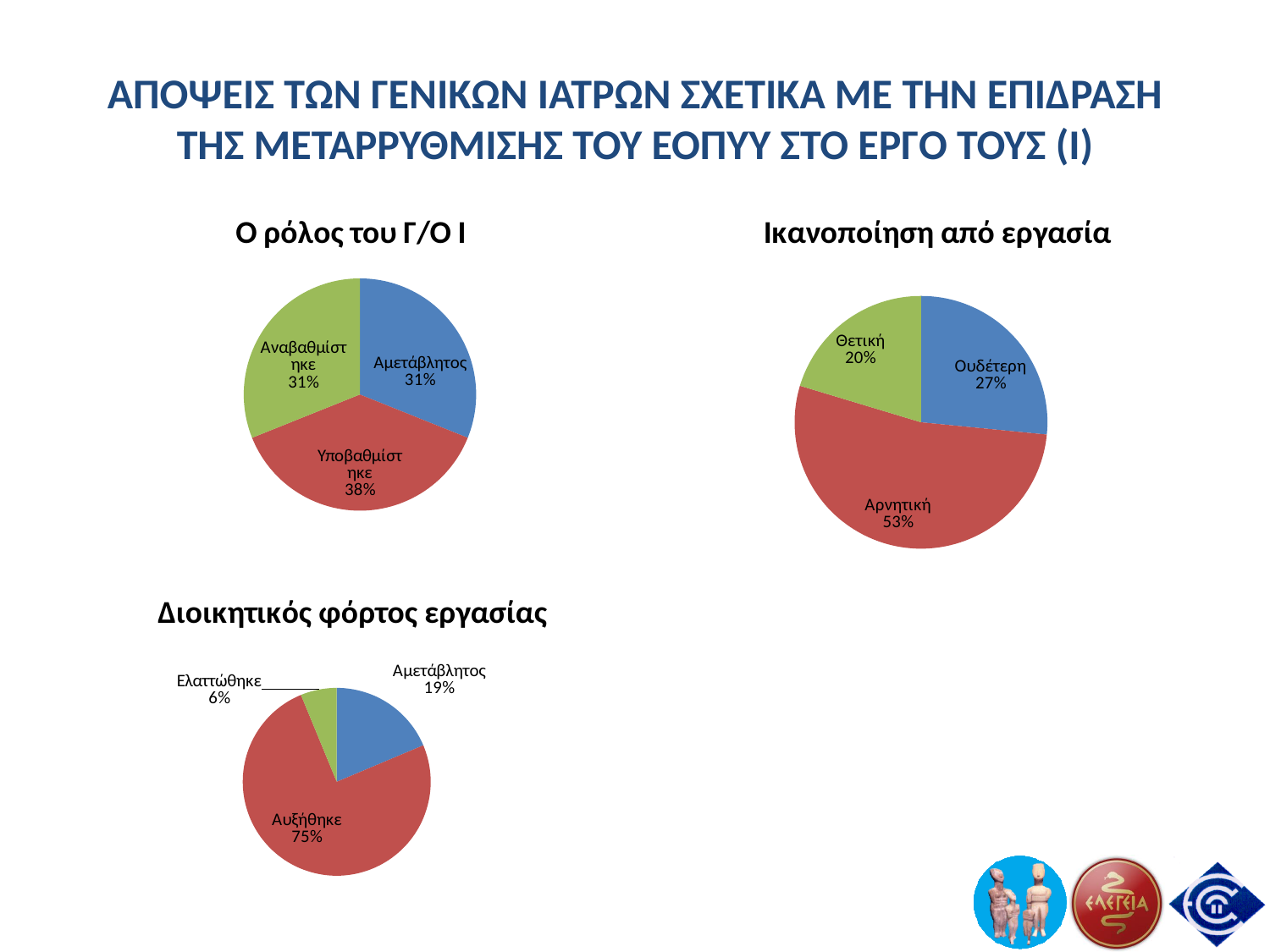
In the chart titled "Ο ρόλος του Γ/Ο Ι", how many slices does the pie have? 3 In the chart titled "Ο ρόλος του Γ/Ο Ι", what share does "Υποβαθμίστηκε" have? 38% In the chart titled "Ο ρόλος του Γ/Ο Ι", which category has the largest slice? Υποβαθμίστηκε In the chart titled "Ικανοποίηση από εργασία", what share does "Αρνητική" have? 53% In the chart titled "Διοικητικός φόρτος εργασίας", what share does "Ελαττώθηκε" have? 6% How many charts are shown on the slide? 3 In the chart titled "Ικανοποίηση από εργασία", which is larger, "Ουδέτερη" or "Θετική"? Ουδέτερη What type of chart is the chart titled "Διοικητικός φόρτος εργασίας"? Pie chart In the chart titled "Ικανοποίηση από εργασία", what is the difference between the shares of "Αρνητική" and "Ουδέτερη"? 26% In the chart titled "Διοικητικός φόρτος εργασίας", what is the difference between the shares of "Αμετάβλητος" and "Ελαττώθηκε"? 13% In the chart titled "Ικανοποίηση από εργασία", which category has the smallest slice? Θετική